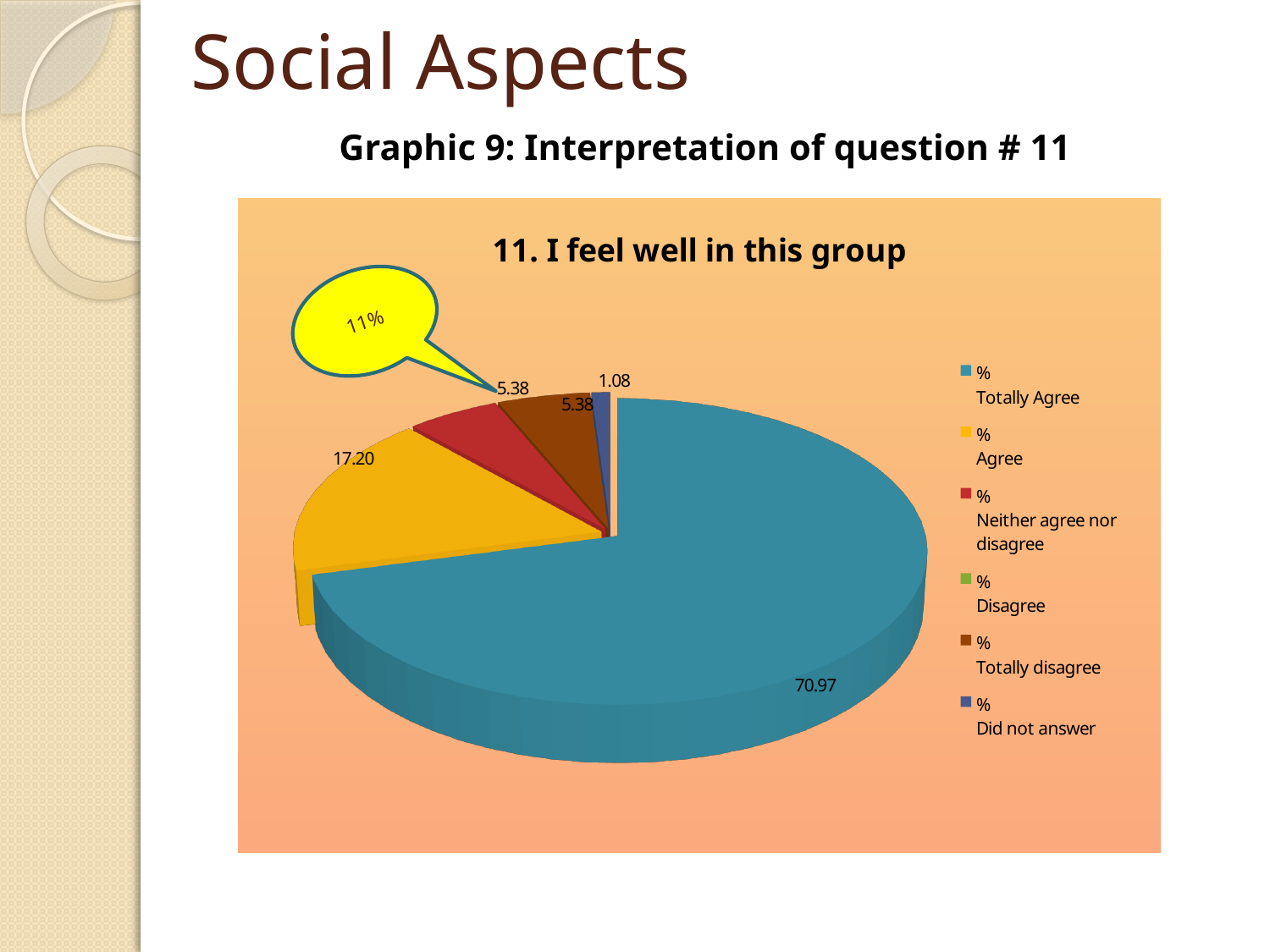
What is the title of the chart? 11. I feel well in this group What type of chart is shown on the slide? Pie chart What percentage is written in the yellow callout bubble? 11% What value is shown for the Totally Agree slice? 70.97 How many entries does the legend list? 6 What is the difference between the Totally Agree value and the Agree value? 53.77 What is the combined value of the Neither agree nor disagree and Totally disagree slices? 10.76 Which category has the largest slice of the pie? Totally Agree What value is shown for the Did not answer slice? 1.08 What value is shown for the Agree slice? 17.20 What value is shown for the Neither agree nor disagree slice? 5.38 Which is larger, the Agree slice or the Totally disagree slice? Agree